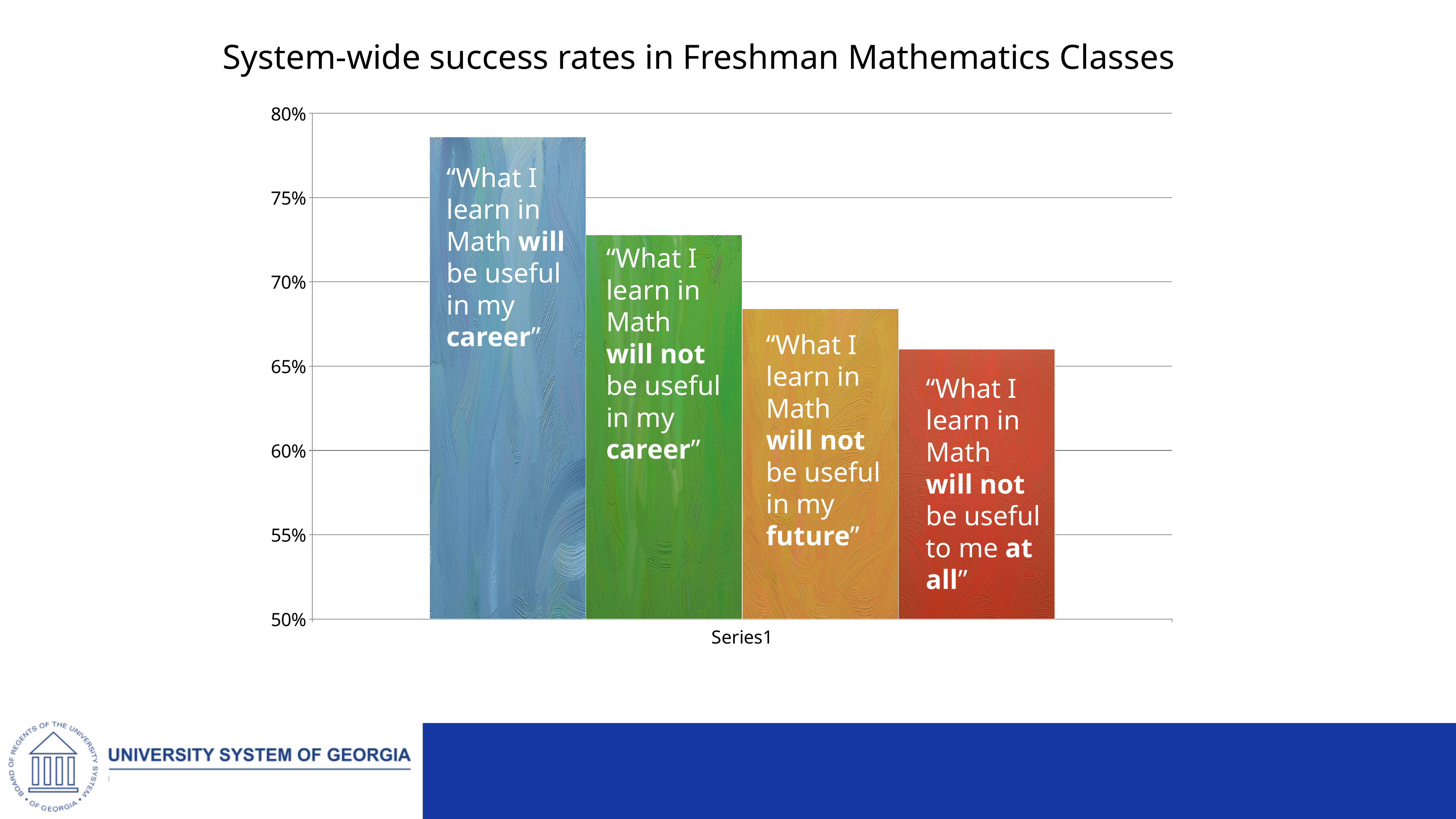
What is the title of the chart? System-wide success rates in Freshman Mathematics Classes Do the success rates rise or fall moving from left to right across the bars? Fall Is the success rate for "What I learn in Math will be useful in my career" greater or less than 75%? greater Which bar has the highest success rate? "What I learn in Math will be useful in my career" What label appears below the bars on the x axis? Series1 Is the success rate for "What I learn in Math will not be useful to me at all" greater or less than 70%? less Which bar has the lowest success rate? "What I learn in Math will not be useful to me at all" What kind of chart is shown on the slide? Bar chart Is the success rate for "What I learn in Math will not be useful in my career" greater or less than 70%? greater Which has a higher success rate: "What I learn in Math will not be useful in my career" or "What I learn in Math will not be useful in my future"? "What I learn in Math will not be useful in my career" How many bars are plotted in the chart? 4